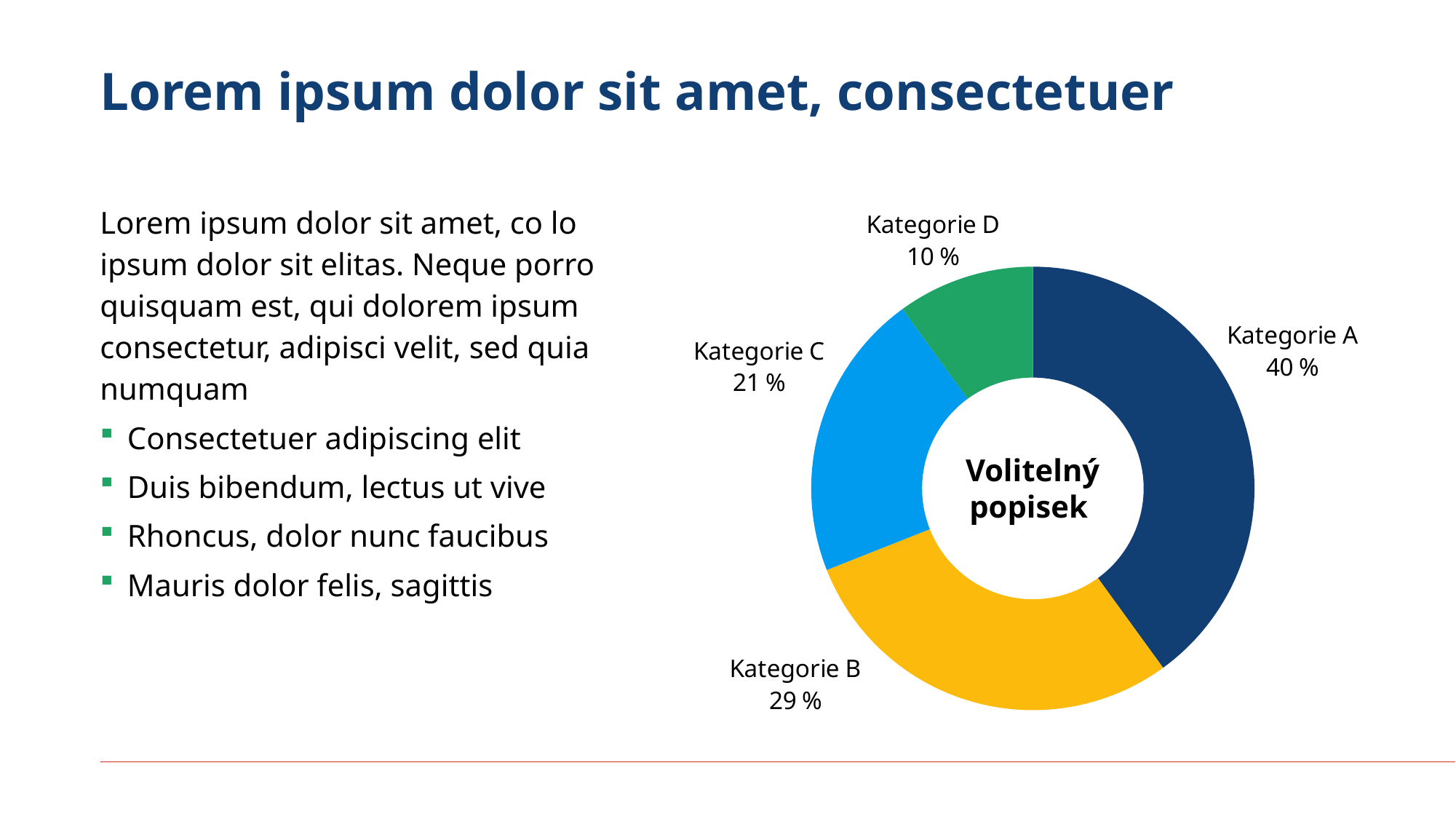
What is the value for Kategorie C? 21 % Which is larger, Kategorie C or Kategorie D? Kategorie C How many categories are shown in the chart? 4 What is the value for Kategorie A? 40 % What text is shown in the centre of the doughnut chart? Volitelný popisek Which category has the smallest share? Kategorie D What is the value for Kategorie B? 29 % What is the difference between the values for Kategorie A and Kategorie B? 11 % Which category has the largest share? Kategorie A What kind of chart is shown on the slide? Doughnut chart What is the value for Kategorie D? 10 % What colour is the Kategorie B slice? Yellow